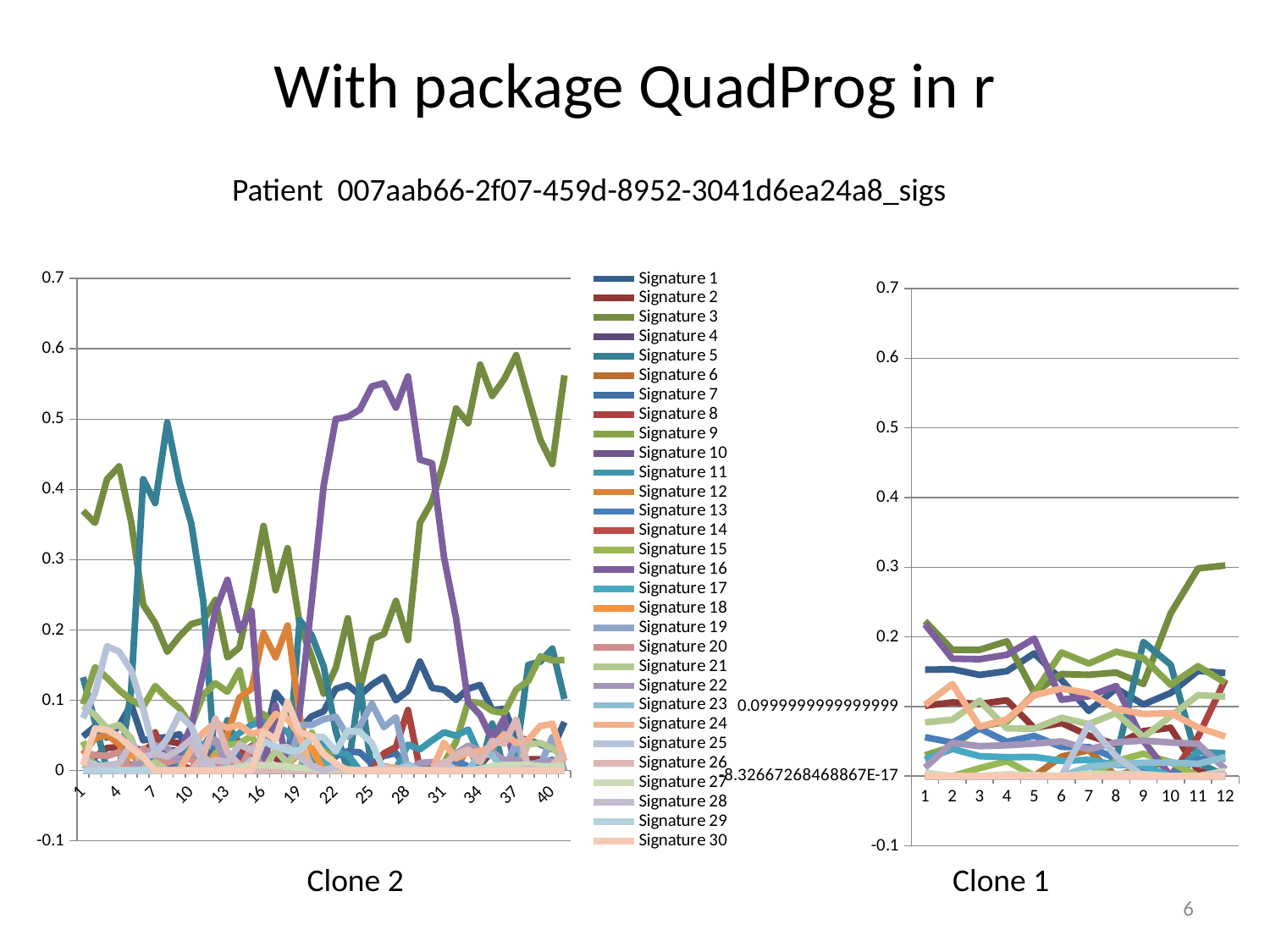
How many points are on the x axis of the Clone 1 chart? 12 What is the highest value shown on the y axis of the Clone 2 chart? 0.7 In the Clone 1 chart, is the highest value reached by any line at point 12 greater or less than 0.4? less What is the name of the last series in the legend? Signature 30 What kind of chart is the Clone 1 chart on the right? line chart What kind of chart is the Clone 2 chart on the left? line chart What is the name of the first series in the legend? Signature 1 In the Clone 2 chart, is the highest value reached by any line greater or less than 0.5? greater How many series does the legend list? 30